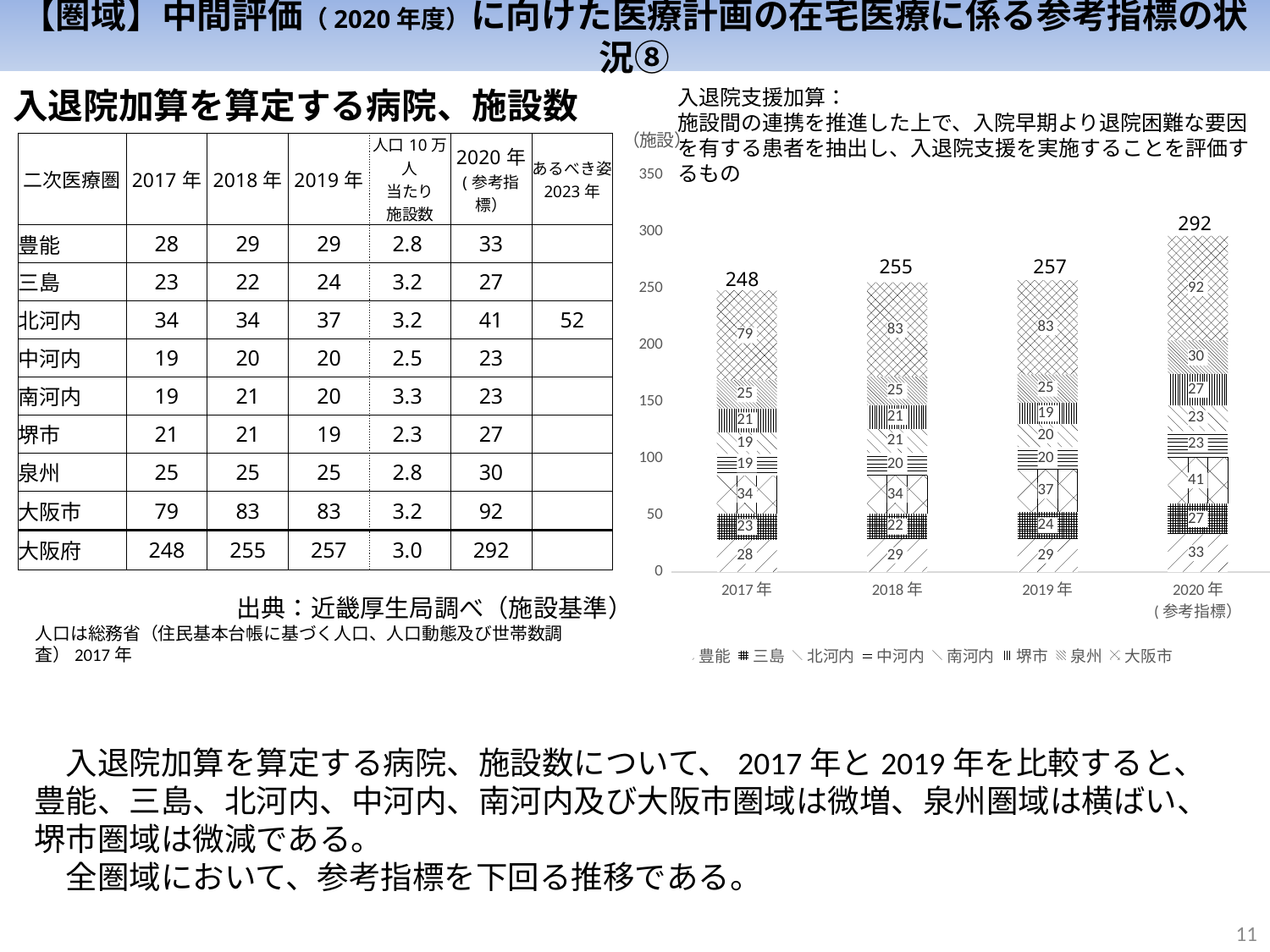
What is the total of the stacked bar for 2017年? 248 Is the stacked bar total for 2018年 greater or less than 250? greater Which year has the highest stacked bar total? 2020年(参考指標) What is the total of the stacked bar for 2020年(参考指標)? 292 What is the difference between the stacked bar totals for 2020年(参考指標) and 2019年? 35 What is the value of the 大阪市 segment in the 2019年 bar? 83 How many series does the chart legend list? 8 Which year has the lowest stacked bar total? 2017年 What is the value of the 北河内 segment in the 2020年(参考指標) bar? 41 How many bars (categories) are plotted on the x axis of the chart? 4 Do the stacked bar totals rise or fall from 2017年 to 2020年(参考指標)? rise What type of chart is shown on the slide? stacked bar chart